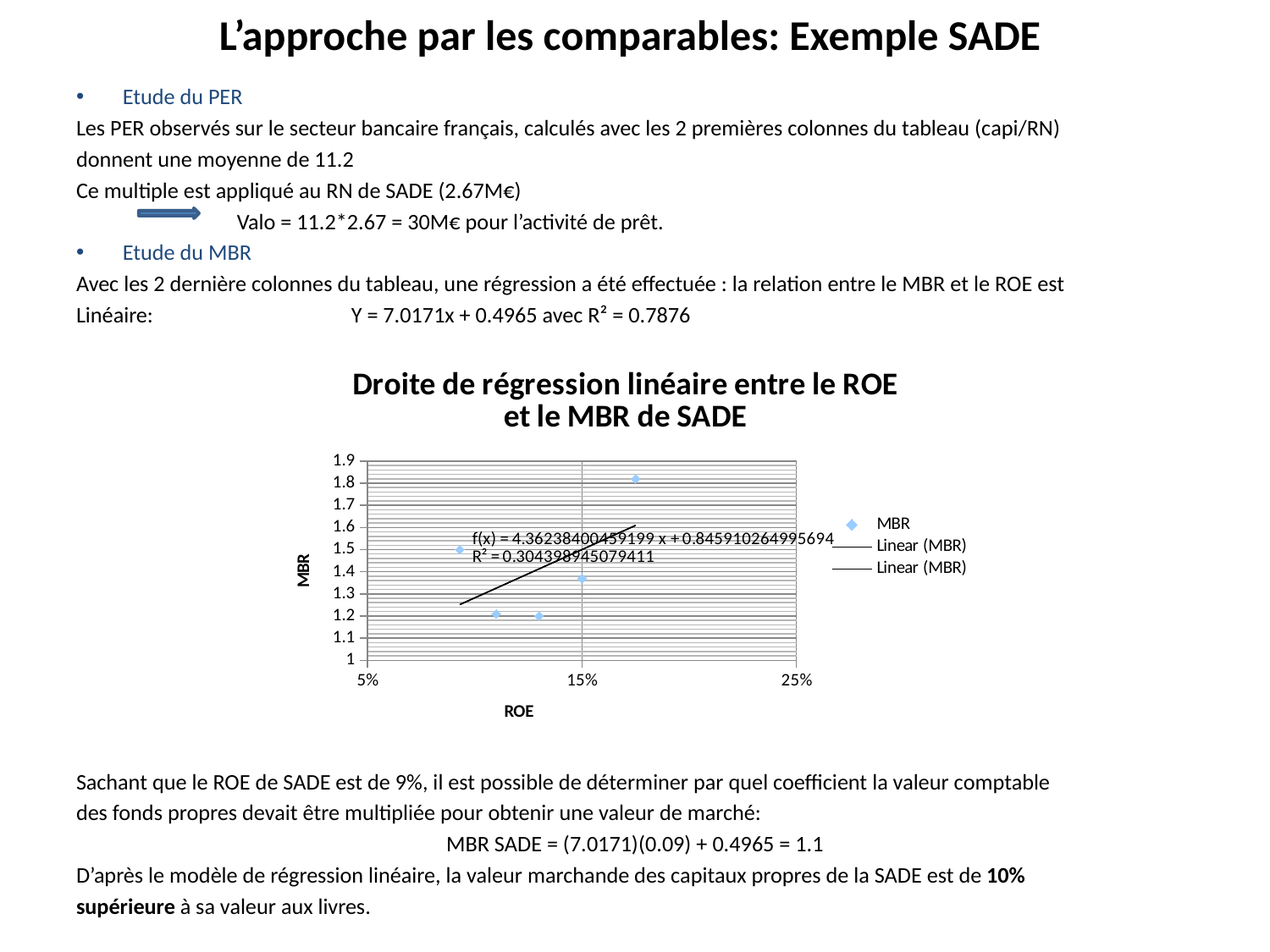
Is the MBR value of the point with the highest ROE greater or less than the MBR value of the point with the lowest ROE? greater Does the fitted trendline rise or fall as ROE increases? rise How many entries does the chart legend list? 3 Is the MBR value of the lowest plotted point greater or less than 1.3? less What R² value is printed on the chart? R² = 0.304398945079411 What kind of chart is shown on the slide? scatter chart What is the trendline equation printed on the chart? f(x) = 4.36238400459199 x + 0.845910264995694 What is the label of the vertical axis of the chart? MBR What is the title of the chart? Droite de régression linéaire entre le ROE et le MBR de SADE How many data points are plotted in the chart? 5 What is the highest tick value shown on the vertical axis of the chart? 1.9 Is the MBR value of the highest plotted point greater or less than 1.7? greater